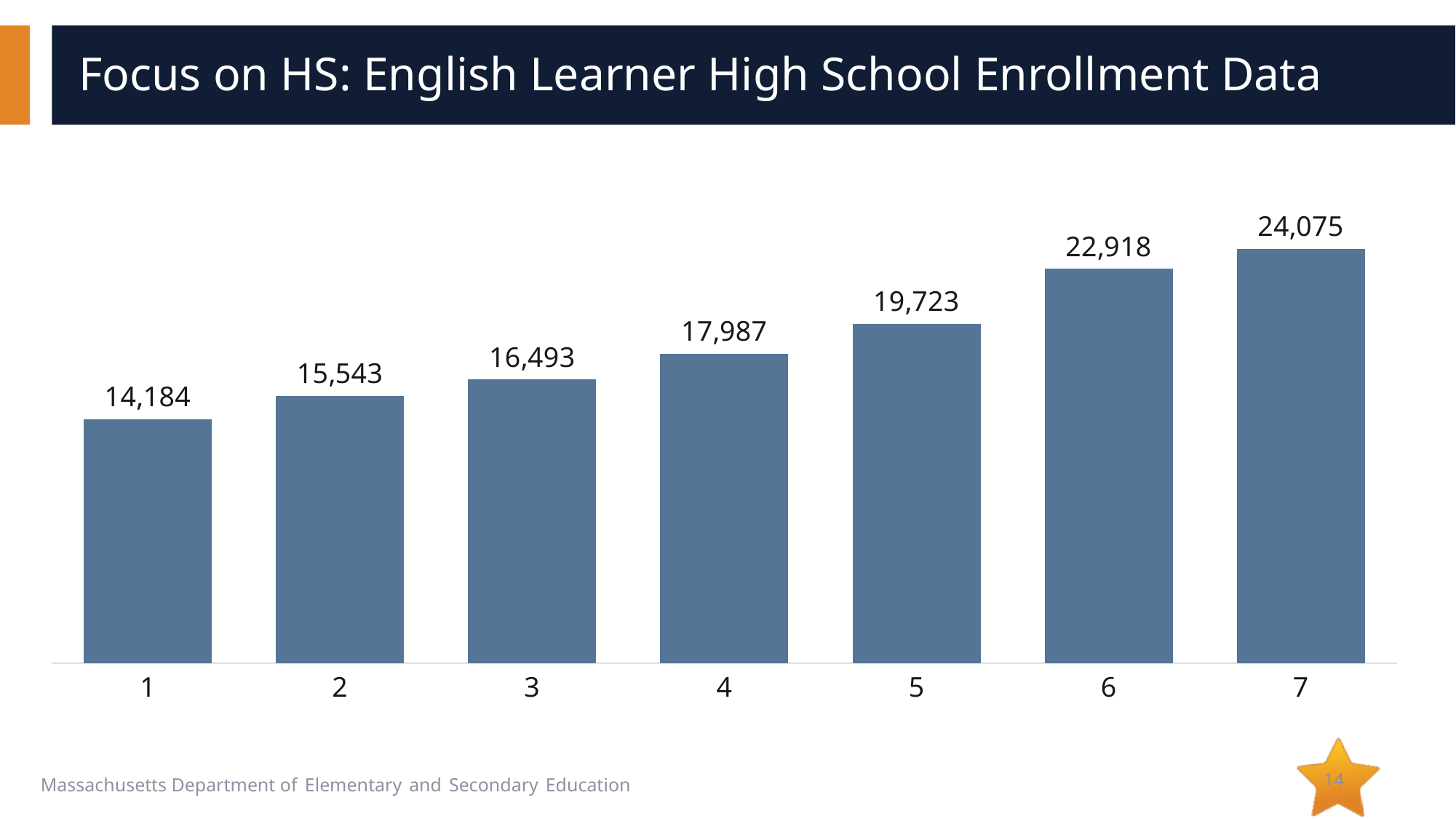
How many bars are shown in the chart? 7 What is the difference between the values for category 7 and category 1? 9,891 Do the values rise or fall from category 1 to category 7? rise What is the value for category 4? 17,987 Which category has the lowest value? 1 What is the value for category 7? 24,075 Which is larger, the value for category 3 or the value for category 5? 5 Which category has the highest value? 7 What kind of chart is shown on the slide? bar chart What is the difference between the values for category 6 and category 5? 3,195 What is the title of the slide containing the chart? Focus on HS: English Learner High School Enrollment Data What is the value for category 1? 14,184